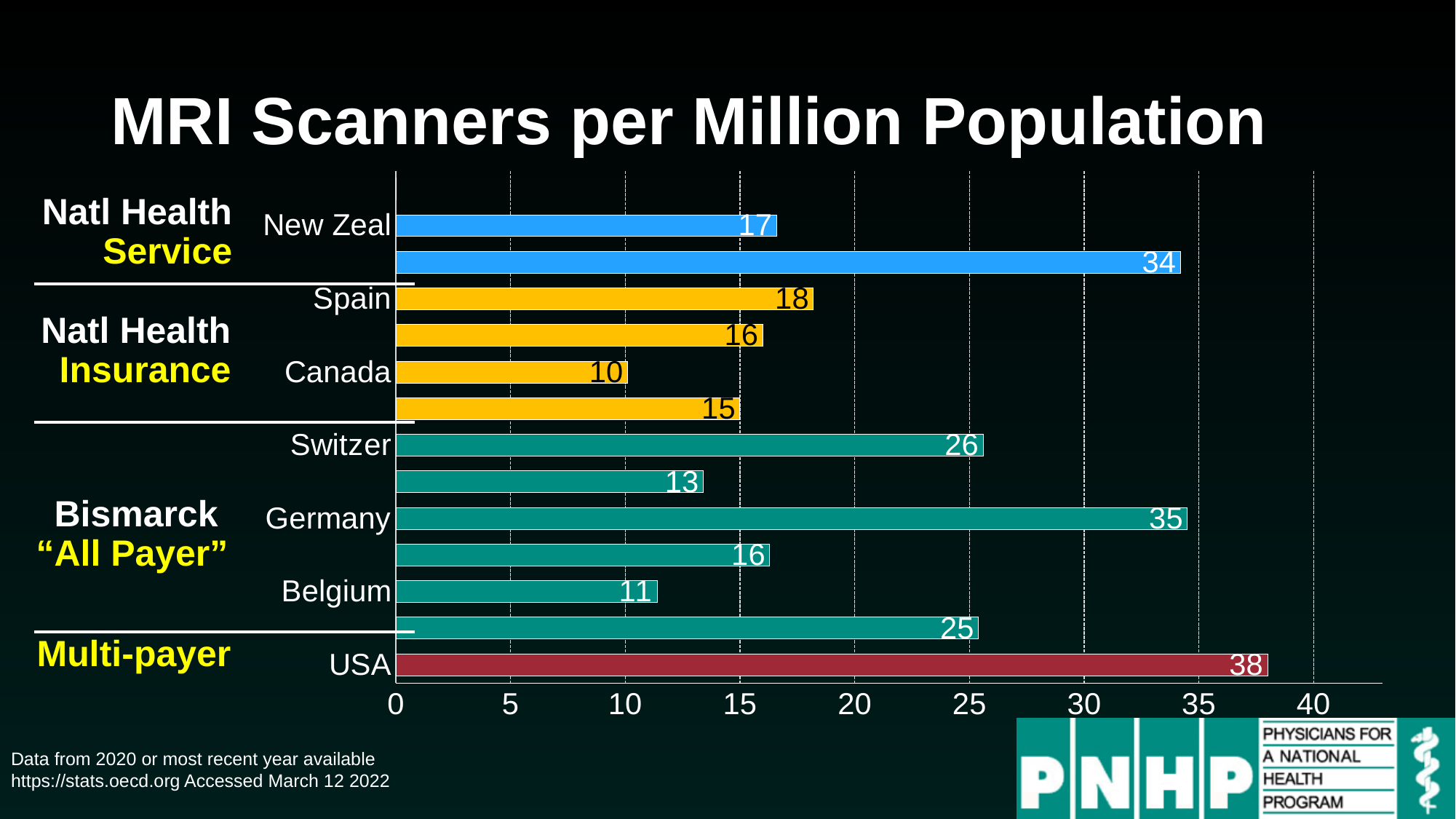
What is the value for Canada? 10 What is the value for USA? 38 What is the difference between the values for USA and Germany? 3 Which country has the lowest number of MRI scanners per million population? Canada What is the difference between the values for Switzer and Belgium? 15 What is the value for Spain? 18 How many bars are plotted in the chart? 13 What is the title of the chart? MRI Scanners per Million Population Which country has the highest number of MRI scanners per million population? USA What kind of chart is shown on the slide? Bar chart What is the value for Germany? 35 Which is larger, the value for New Zeal or the value for Spain? Spain